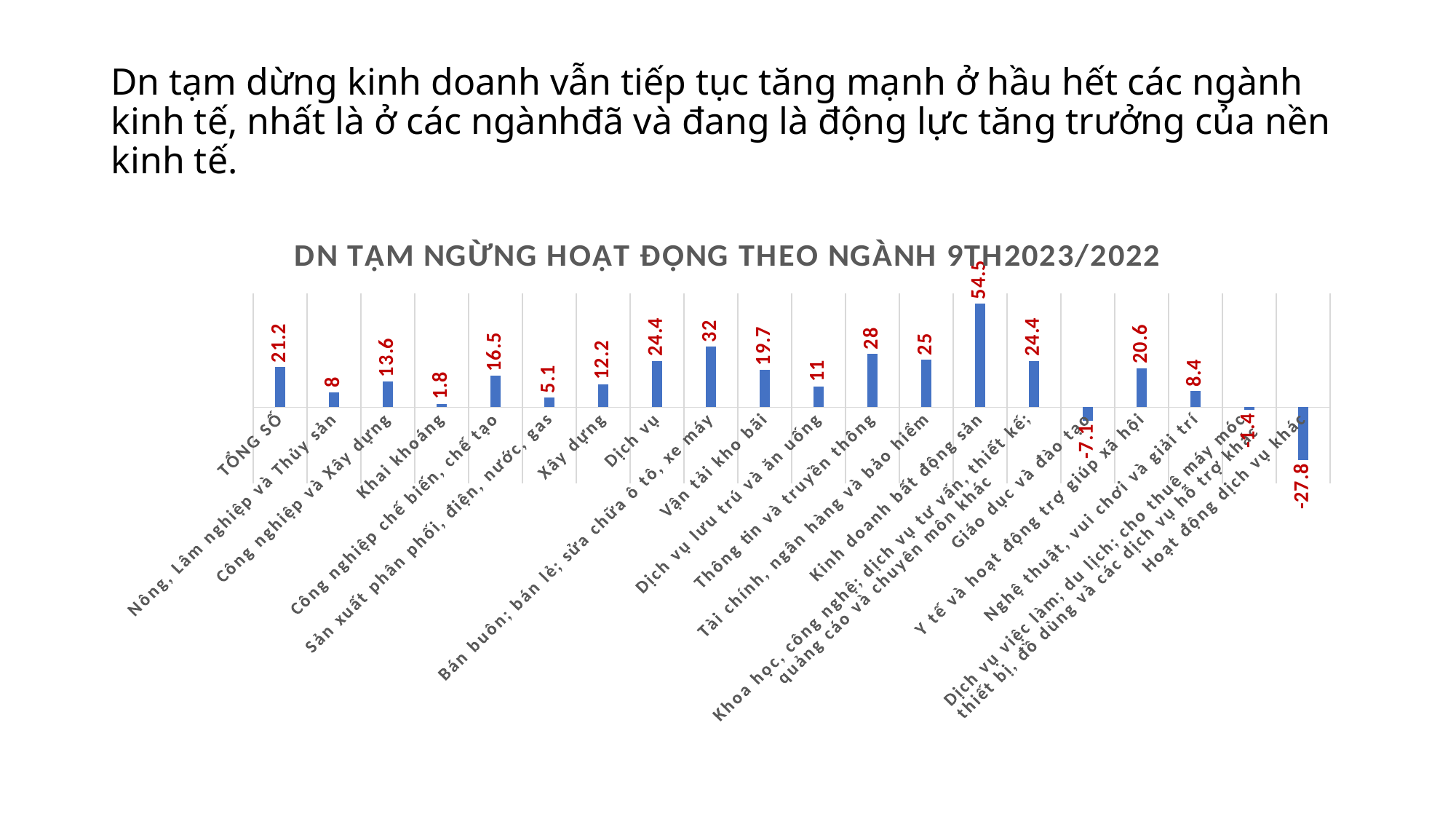
How many categories are shown in the chart? 20 What type of chart is shown on the slide? Bar chart What is the value for TỔNG SỐ? 21.2 Which category has the highest value? Kinh doanh bất động sản What is the value for Giáo dục và đào tạo? -7.1 What is the value for Hoạt động dịch vụ khác? -27.8 Which is larger, the value for Thông tin và truyền thông or the value for Tài chính, ngân hàng và bảo hiểm? Thông tin và truyền thông Which category has the lowest value? Hoạt động dịch vụ khác What is the difference between the values for Kinh doanh bất động sản and Bán buôn; bán lẻ; sửa chữa ô tô, xe máy? 22.5 How many categories have a negative value? 3 What is the title of the chart? DN TẠM NGỪNG HOẠT ĐỘNG THEO NGÀNH 9TH2023/2022 What is the value for Kinh doanh bất động sản? 54.5